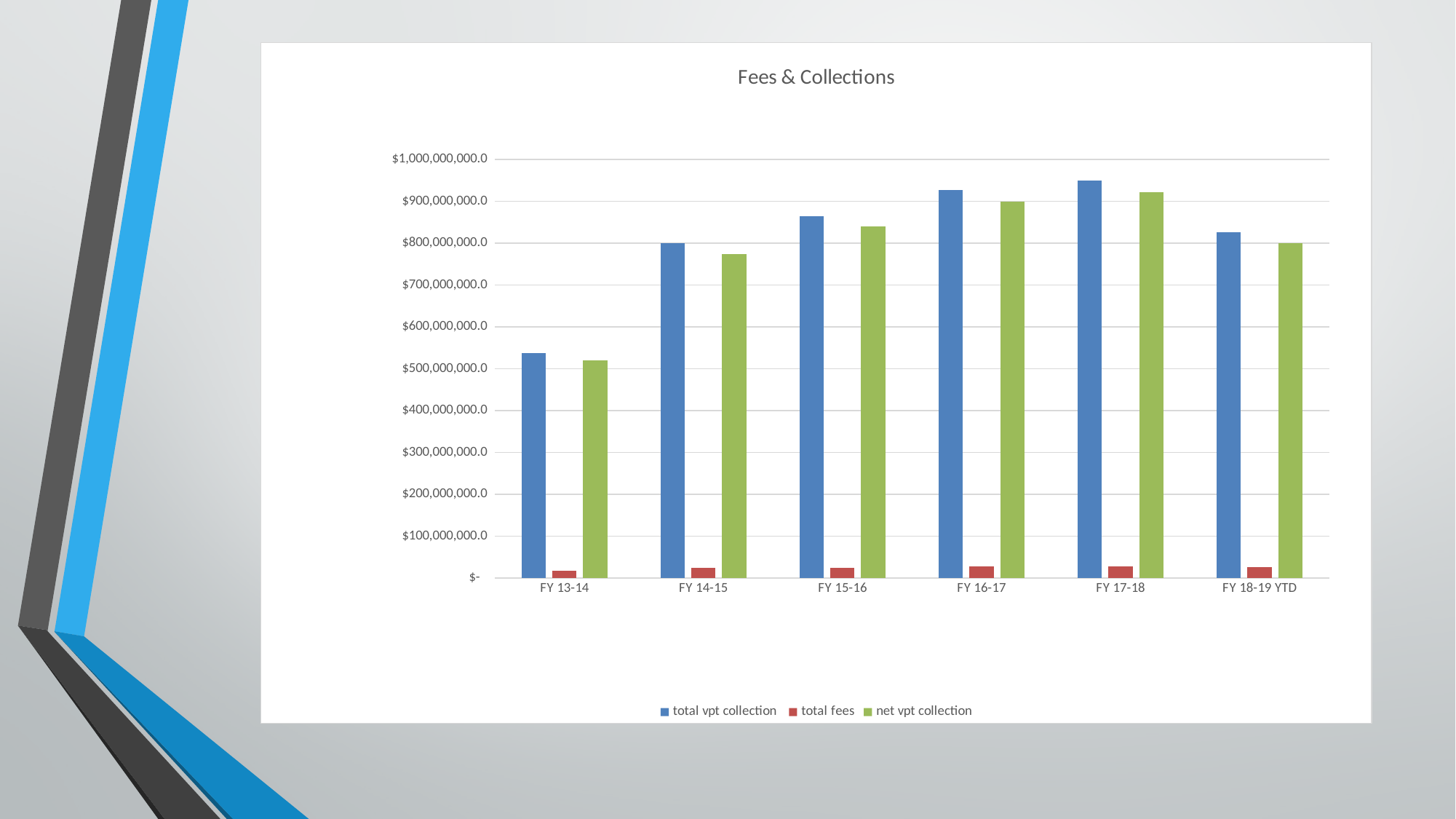
What is the title of the chart? Fees & Collections Which fiscal year has the highest total vpt collection? FY 17-18 Is the total vpt collection for FY 13-14 greater or less than $600,000,000.0? less How many fiscal year categories are shown on the x axis? 6 Which fiscal year has the lowest net vpt collection? FY 13-14 Is the net vpt collection for FY 14-15 greater or less than $800,000,000.0? less Is the total fees value for FY 16-17 greater or less than $100,000,000.0? less Which is larger, the total vpt collection for FY 15-16 or for FY 14-15? FY 15-16 What kind of chart is shown on the slide? bar chart How many series does the legend list? 3 Does the total vpt collection rise or fall from FY 13-14 to FY 17-18? rises